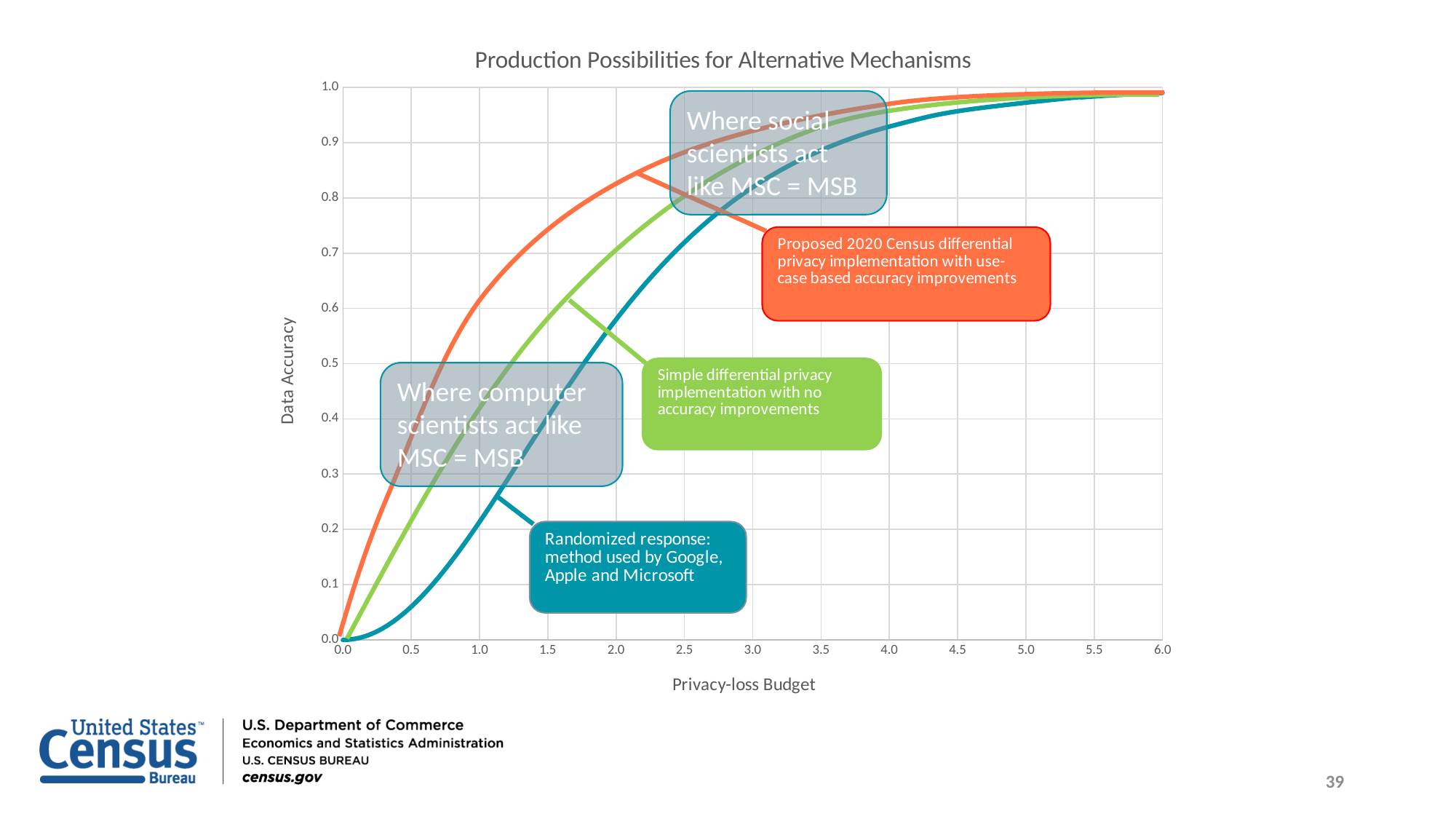
What is the label of the x axis of the chart? Privacy-loss Budget At a privacy-loss budget of 2.0, is the data accuracy of the proposed 2020 Census differential privacy curve greater or less than 0.7? greater Which mechanism has the lowest data accuracy at a privacy-loss budget of 1.0? Randomized response: method used by Google, Apple and Microsoft How many curves (mechanisms) are plotted on the chart? 3 At a privacy-loss budget of 1.0, is the data accuracy of the randomized response curve greater or less than 0.4? less What is the data accuracy of all three curves at a privacy-loss budget of 0.0? 0.0 What is the title of the chart? Production Possibilities for Alternative Mechanisms What kind of chart is shown on the slide? Line chart Do the curves rise or fall as the privacy-loss budget increases? Rise At a privacy-loss budget of 1.0, is the data accuracy of the simple differential privacy curve greater or less than 0.6? less Which mechanism has the highest data accuracy at a privacy-loss budget of 1.0? Proposed 2020 Census differential privacy implementation with use-case based accuracy improvements At a privacy-loss budget of 1.5, which has higher data accuracy: the proposed 2020 Census differential privacy curve or the randomized response curve? Proposed 2020 Census differential privacy curve